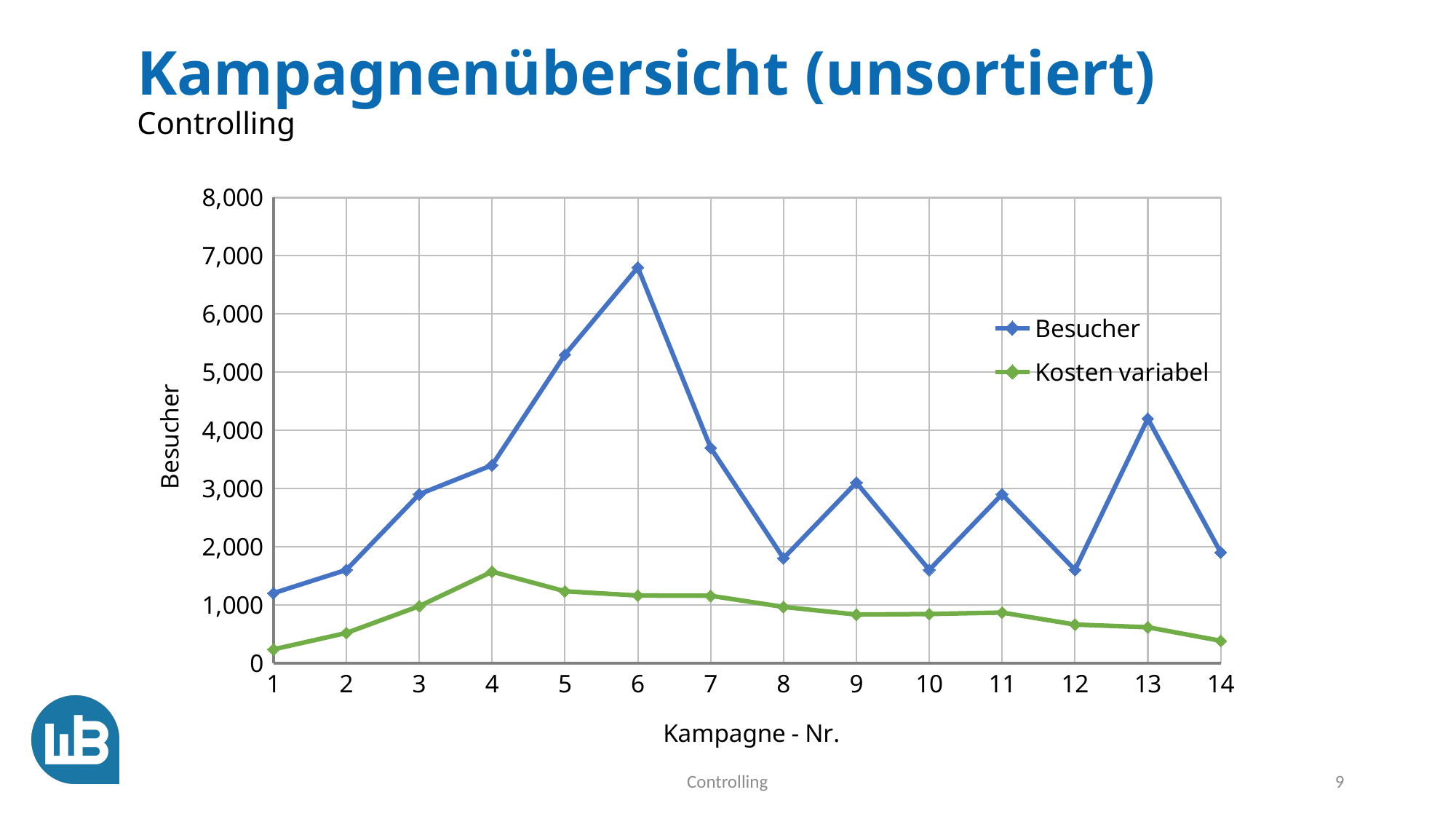
How many campaigns are plotted along the x axis? 14 What kind of chart is shown on the slide? line chart Which campaign number has the highest Kosten variabel value? 4 Is the Besucher value for campaign 6 greater or less than 6,000? greater Which campaign number has the lowest Kosten variabel value? 1 Which campaign number has the highest Besucher value? 6 How many series does the legend list? 2 Is the Kosten variabel value for campaign 4 greater or less than 2,000? less Which is larger, the Besucher value for campaign 5 or for campaign 7? campaign 5 Is the Besucher value for campaign 13 greater or less than 4,000? greater Do the Kosten variabel values rise or fall from campaign 4 to campaign 14? fall What is the label of the x axis? Kampagne - Nr.